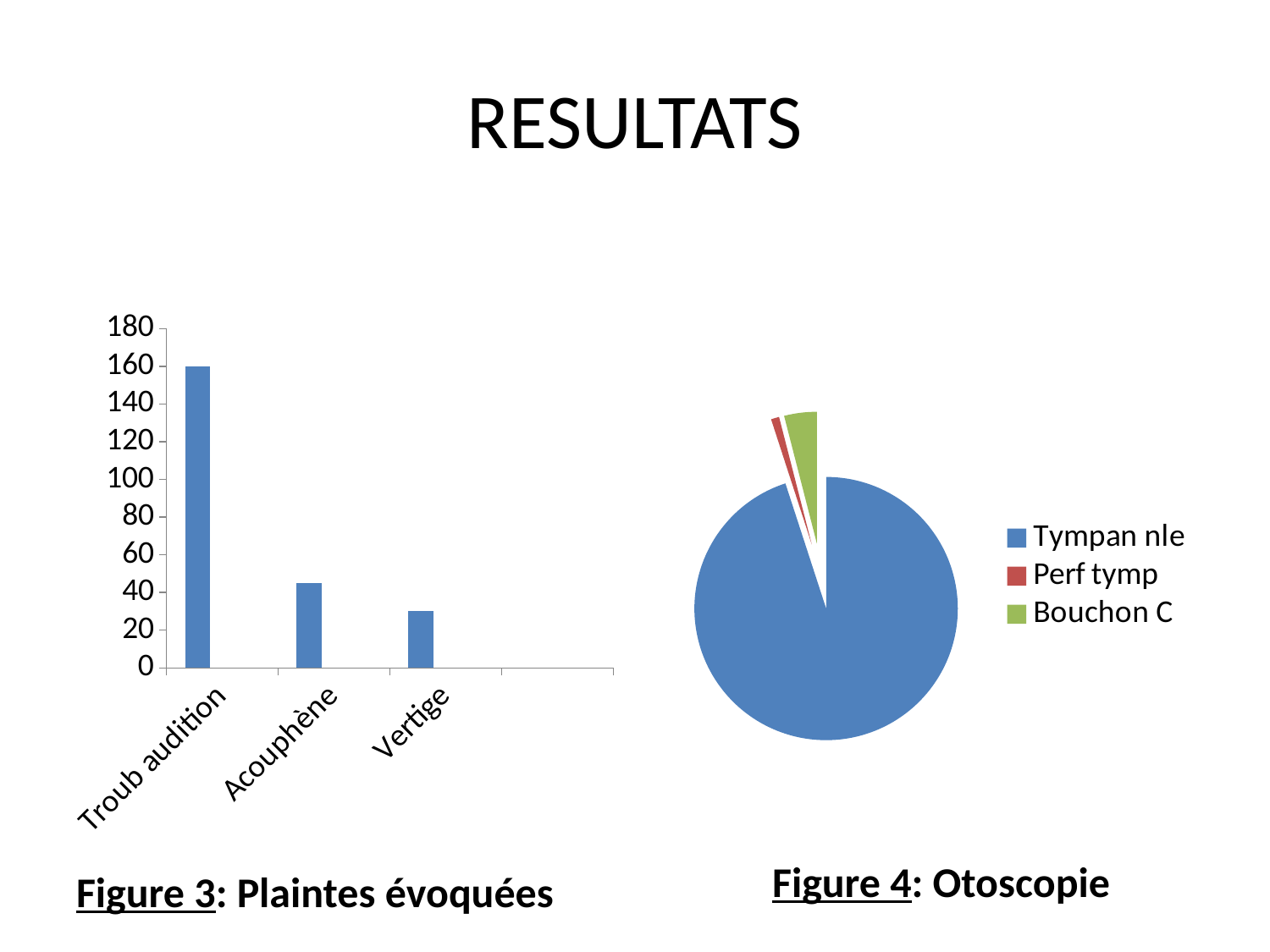
How many entries does the legend of Figure 4: Otoscopie list? 3 In Figure 3: Plaintes évoquées, is the value for Troub audition greater or less than 140? greater How many categories are shown in Figure 3: Plaintes évoquées? 3 In Figure 3: Plaintes évoquées, is the value for Acouphène greater or less than 60? less In Figure 3: Plaintes évoquées, which is larger, the value for Acouphène or the value for Vertige? Acouphène In Figure 4: Otoscopie, which category has the largest slice? Tympan nle In Figure 3: Plaintes évoquées, is the value for Vertige greater or less than 20? greater In Figure 3: Plaintes évoquées, which category has the lowest value? Vertige What kind of chart is Figure 4: Otoscopie? pie chart What kind of chart is Figure 3: Plaintes évoquées? bar chart Do the values in Figure 3: Plaintes évoquées rise or fall from left to right along the x axis? fall In Figure 3: Plaintes évoquées, which category has the highest value? Troub audition